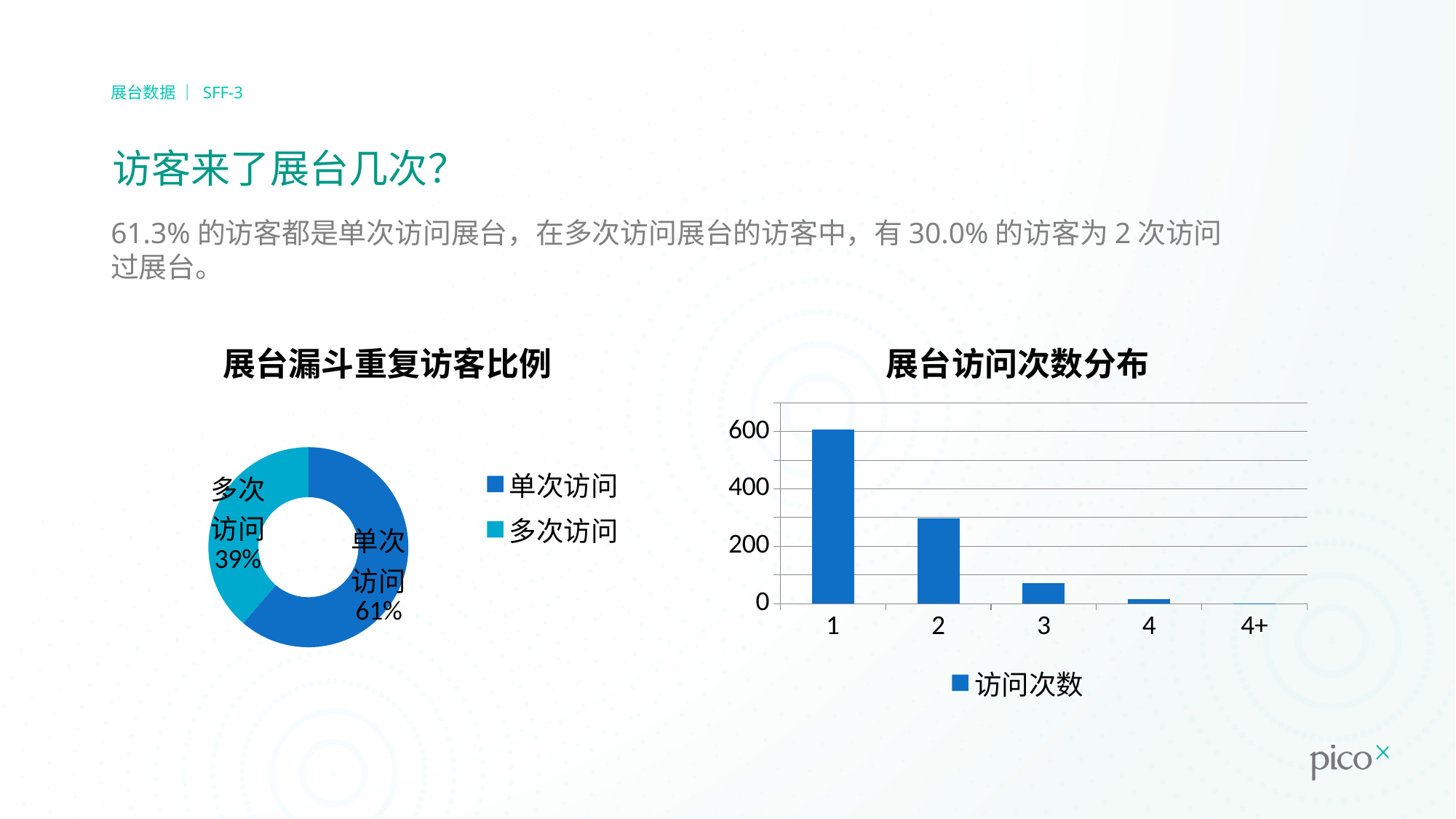
How many entries does the legend of the chart titled 展台漏斗重复访客比例 list? 2 In the chart titled 展台访问次数分布, is the value for category 3 greater or less than 200? less In the chart titled 展台漏斗重复访客比例, which slice is larger, 单次访问 or 多次访问? 单次访问 In the chart titled 展台访问次数分布, do the values rise or fall as you move from category 1 to category 4? fall What kind of chart is the one titled 展台漏斗重复访客比例? Donut (pie) chart In the chart titled 展台漏斗重复访客比例, what percentage is shown for 单次访问? 61% In the chart titled 展台漏斗重复访客比例, by how many percentage points does 单次访问 exceed 多次访问? 22 percentage points In the chart titled 展台访问次数分布, which category has the highest value? 1 What kind of chart is the one titled 展台访问次数分布? Bar chart In the chart titled 展台漏斗重复访客比例, what percentage is shown for 多次访问? 39% How many categories are shown on the x axis of the chart titled 展台访问次数分布? 5 In the chart titled 展台访问次数分布, is the value for category 1 greater or less than 400? greater